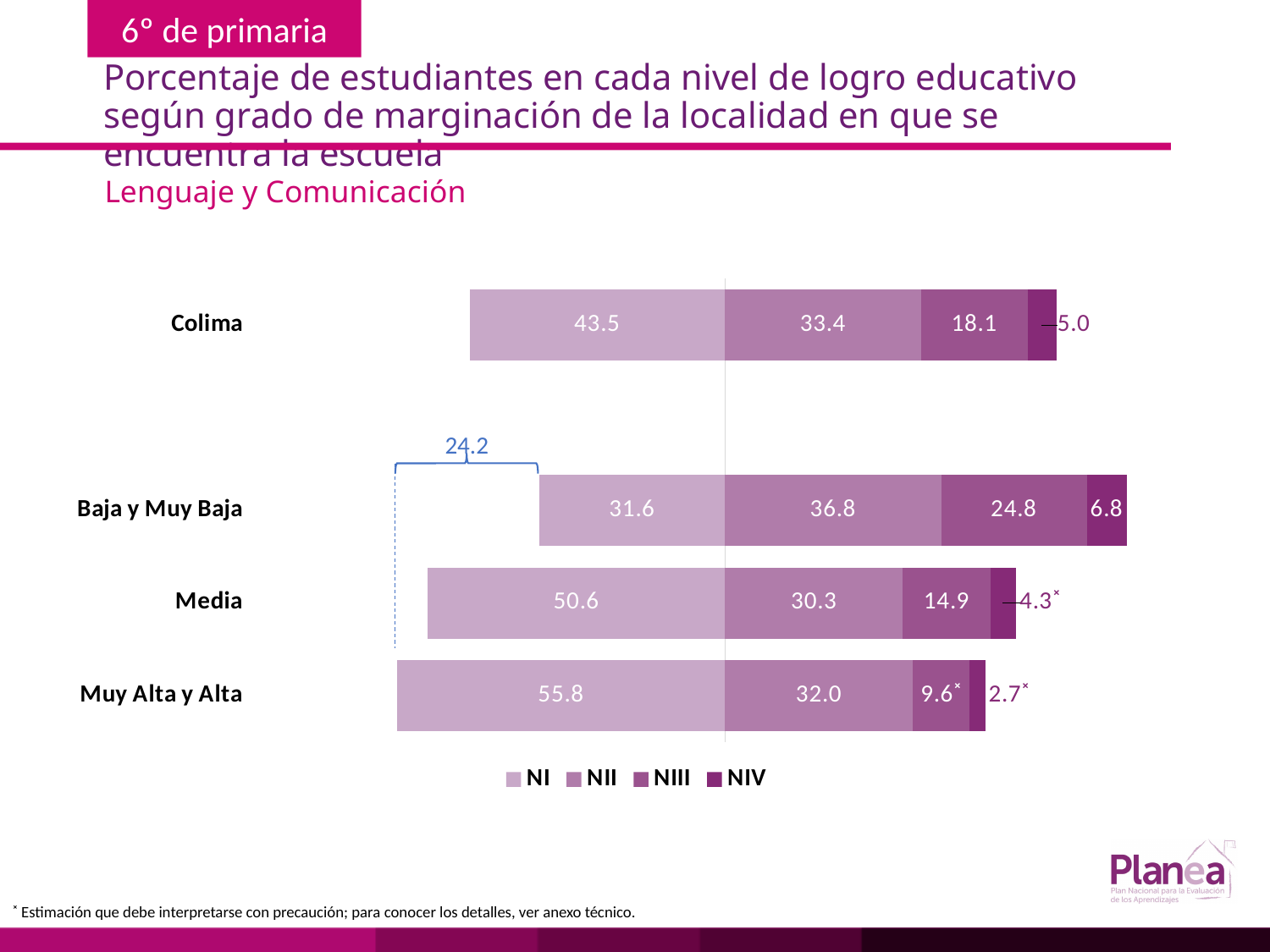
How many series does the legend list? 4 What percentage of students in Colima are at level NI? 43.5 How many categories are shown on the chart? 4 What kind of chart is shown on the slide? Stacked bar chart What is the NII value for the Media category? 30.3 Which is larger, the NII value for Baja y Muy Baja or the NII value for Colima? Baja y Muy Baja Which category has the lowest NIV value? Muy Alta y Alta Which category has the highest NI value? Muy Alta y Alta What is the difference between the NI values of Muy Alta y Alta and Baja y Muy Baja? 24.2 What is the total of the stacked bar for Colima? 100.0 What is the NIII value for Muy Alta y Alta? 9.6 What is the NIV value for Baja y Muy Baja? 6.8